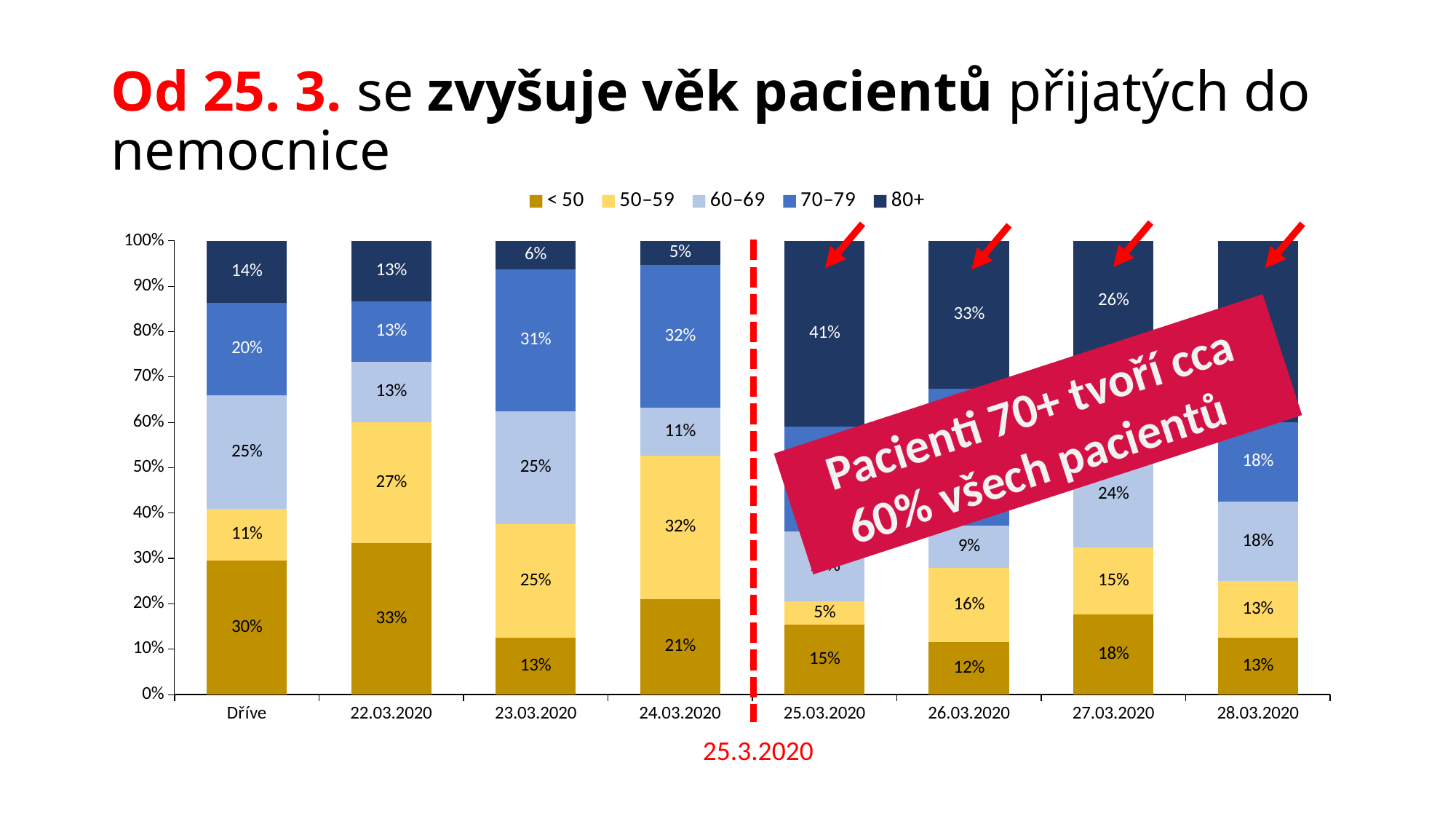
What kind of chart is shown on the slide? stacked bar chart How many categories are shown on the x axis? 8 Which is larger: the < 50 share on 23.03.2020 or on 24.03.2020? 24.03.2020 What is the difference between the 80+ share on 25.03.2020 and on 26.03.2020? 8% Which date is marked by the red dashed vertical line on the chart? 25.3.2020 What is the share of patients aged 60–69 on 27.03.2020? 24% Which category has the highest share of patients aged 80+? 25.03.2020 Which category has the lowest share of patients aged 80+? 24.03.2020 What is the share of patients under 50 (< 50) on 22.03.2020? 33% What is the share of patients aged 80+ on 25.03.2020? 41% How many series does the legend list? 5 What is the share of patients aged 70–79 on 24.03.2020? 32%